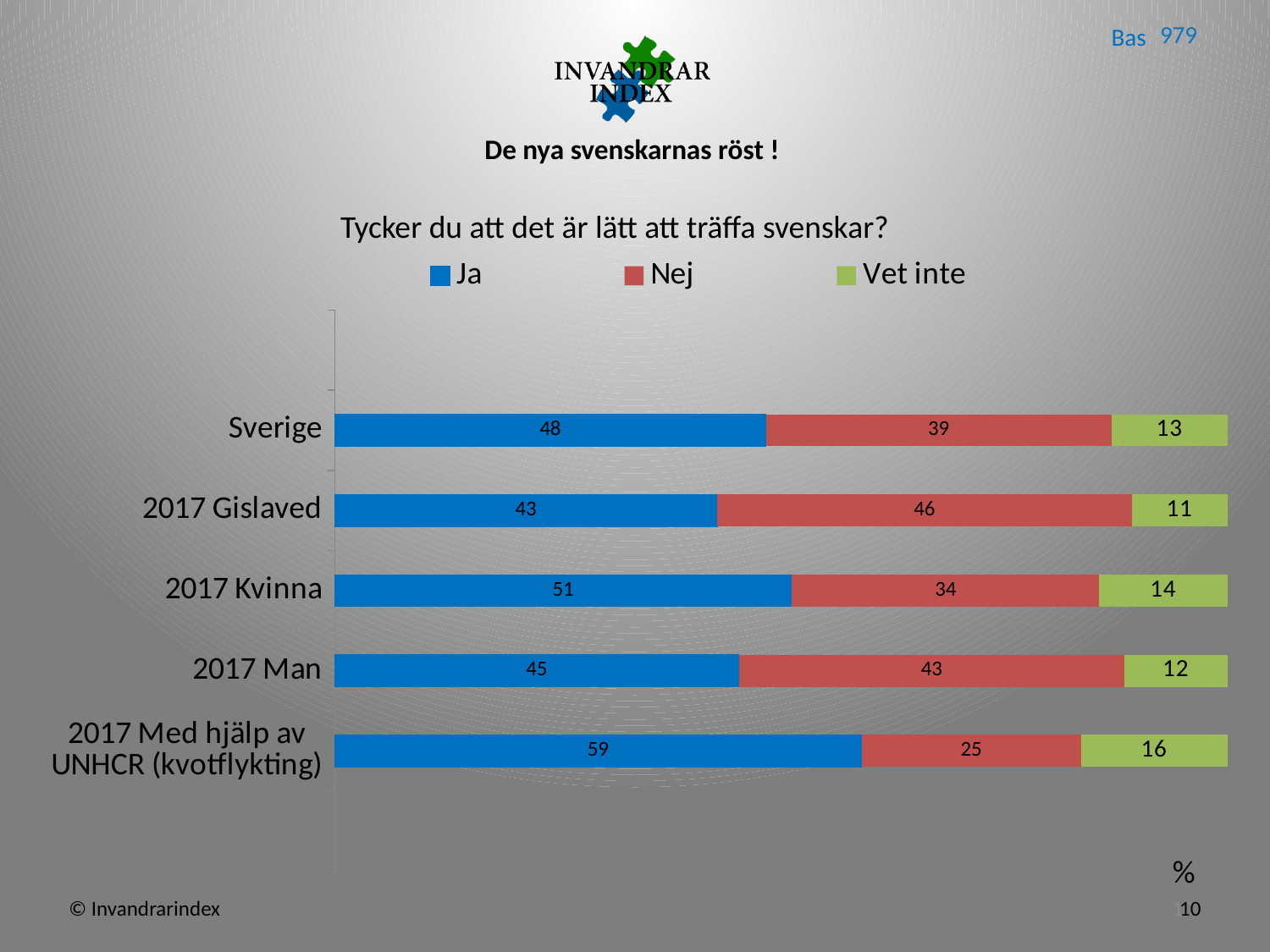
What is the value of "Vet inte" for 2017 Med hjälp av UNHCR (kvotflykting)? 16 What is the value of "Nej" for 2017 Gislaved? 46 Which category has the highest "Ja" value? 2017 Med hjälp av UNHCR (kvotflykting) What is the difference between the "Ja" values for 2017 Kvinna and 2017 Man? 6 Which is larger: the "Nej" value for 2017 Gislaved or for Sverige? 2017 Gislaved What is the value of "Ja" for Sverige? 48 What kind of chart is shown on the slide? Stacked bar chart Which category has the lowest "Nej" value? 2017 Med hjälp av UNHCR (kvotflykting) What is the total of the stacked bar for 2017 Kvinna? 99 What is the question shown as the chart title? Tycker du att det är lätt att träffa svenskar? How many series does the legend list? 3 How many categories are shown on the chart? 5